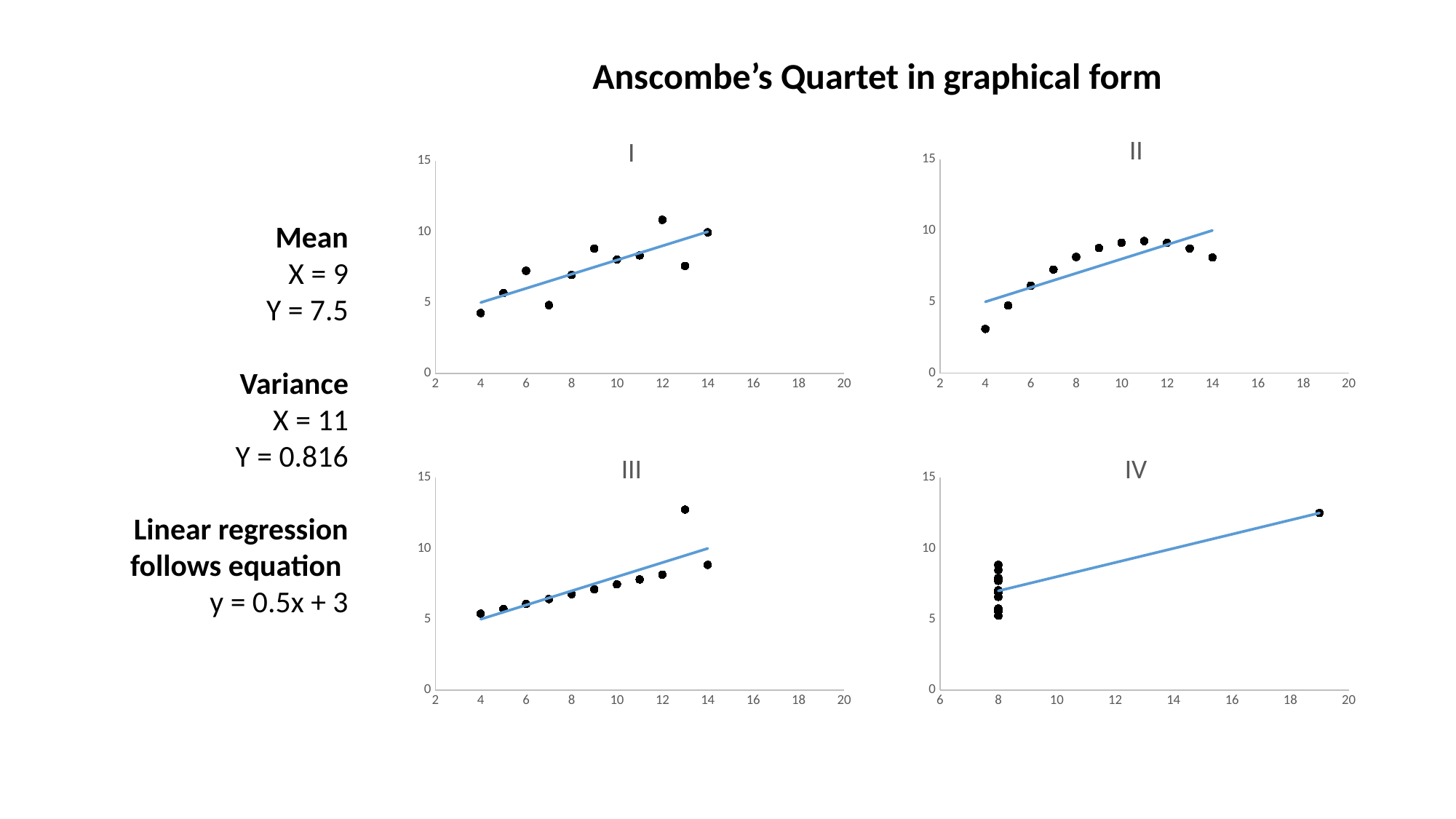
What kind of chart is the chart titled I? scatter chart How many data points are plotted in the chart titled III? 11 How many data points are plotted in the chart titled I? 11 In the chart titled II, at which x value is the lowest y value plotted? 4 In the chart titled III, do the y values generally rise or fall as x increases? rise In the chart titled I, which point has the larger y value: the one at x = 12 or the one at x = 13? x = 12 In the chart titled II, is the y value of the point at x = 4 greater or less than 5? less What are the titles of the four charts on the slide? I, II, III, IV In the chart titled IV, is the y value of the point at x = 19 greater or less than 10? greater In the chart titled III, is the y value of the point at x = 13 greater or less than 10? greater In the chart titled III, at which x value is the highest y value plotted? 13